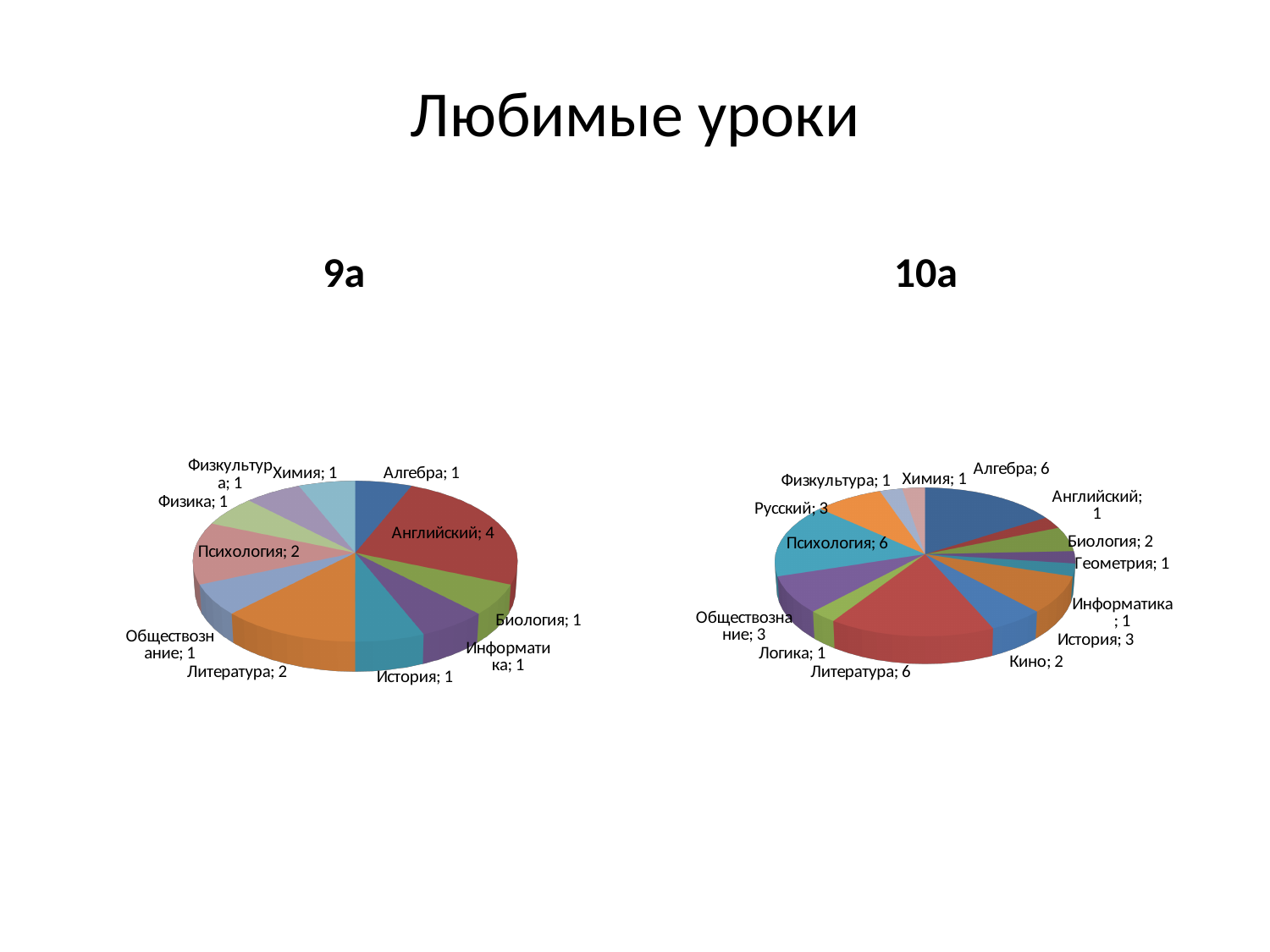
What type of chart is used for the 10а data? Pie chart In the 10а chart, what is the value for История? 3 How many subjects are shown in the 9а chart? 11 In the 10а chart, what is the value for Психология? 6 In the 9а chart, which is larger: Психология or Физика? Психология In the 9а chart, which subject has the largest slice? Английский In the 10а chart, which is larger: Обществознание or Биология? Обществознание In the 9а chart, how many students chose Английский? 4 In the 9а chart, what share of the total does Английский represent? 25% How many subjects are shown in the 10а chart? 14 In the 9а chart, what is the difference between Английский and Литература? 2 In the 10а chart, what is the difference between Алгебра and Кино? 4